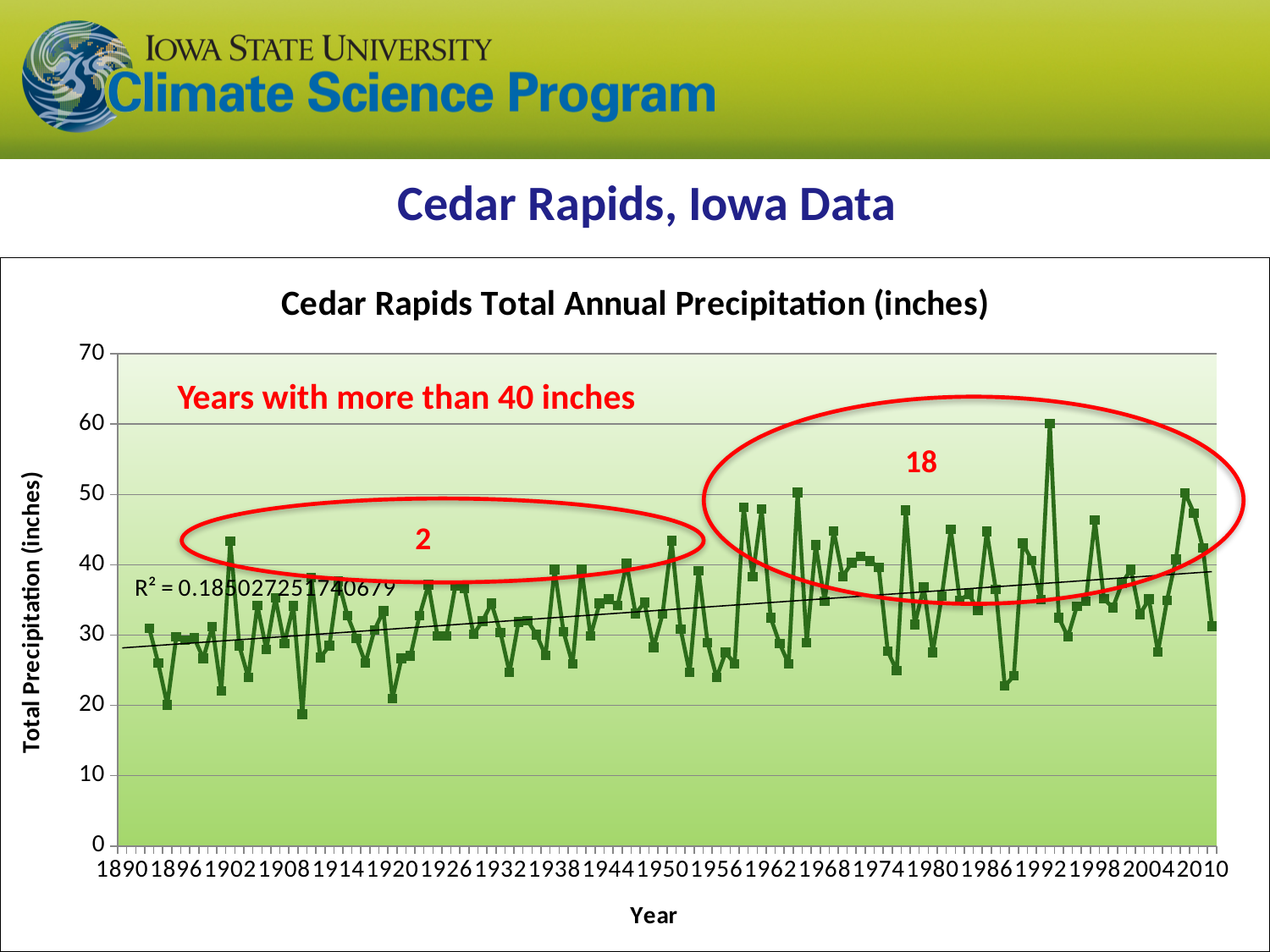
According to the trend line, do precipitation values rise or fall from 1890 to 2010? rise What is the label on the vertical axis of the chart? Total Precipitation (inches) What is the last year label shown on the horizontal axis? 2010 What is the first year label shown on the horizontal axis? 1890 How many years with more than 40 inches are counted in the left (earlier) red ellipse? 2 Is the lowest point on the chart greater or less than 25 inches? less What is the highest tick value shown on the vertical axis? 70 What kind of chart is shown on the slide? line chart Is the highest point on the chart greater or less than 50 inches? greater What is the title of the chart? Cedar Rapids Total Annual Precipitation (inches) How many years with more than 40 inches are counted in the right (later) red ellipse? 18